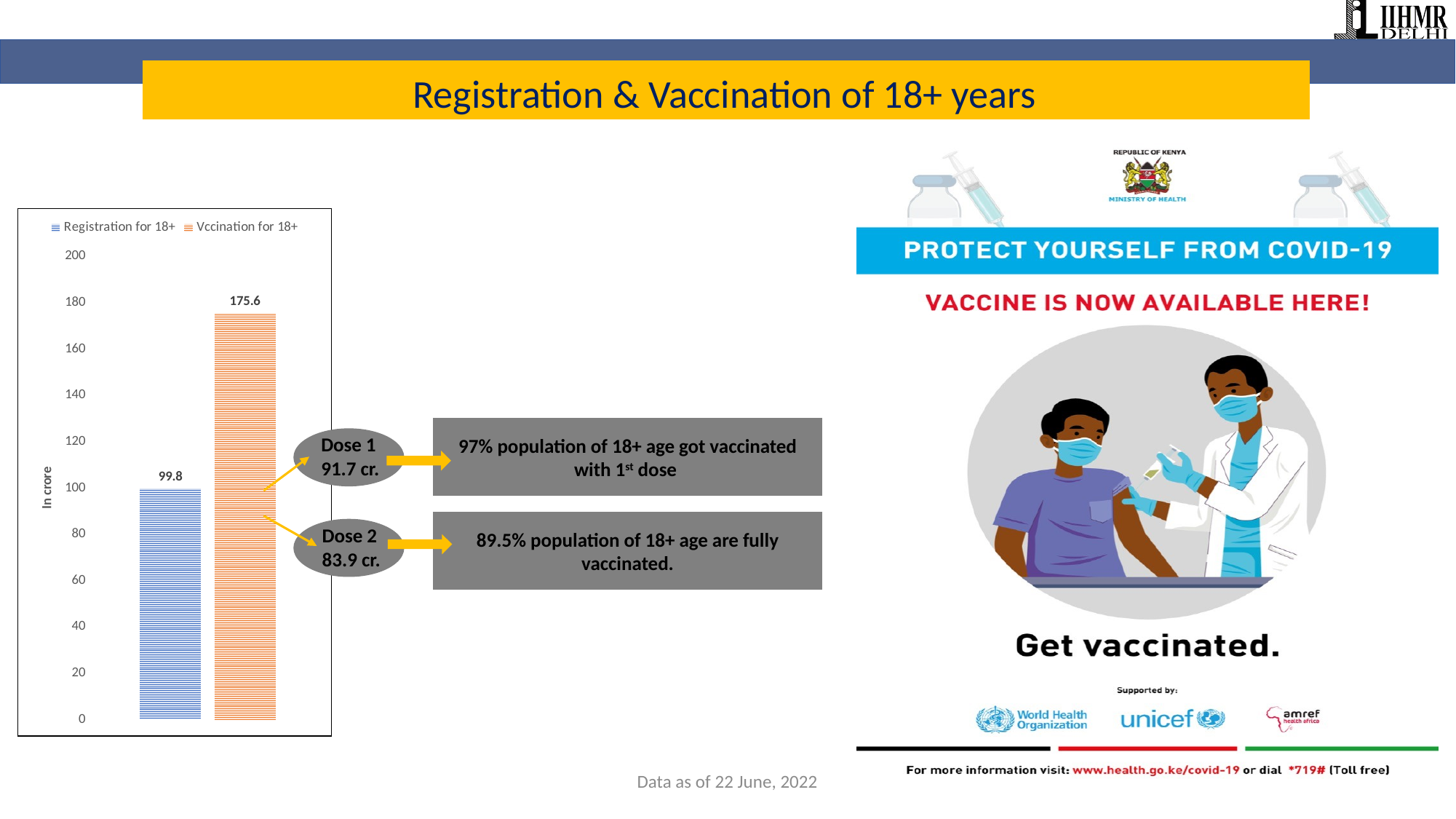
What is the difference between the Vccination for 18+ value and the Registration for 18+ value? 75.8 What is the value of the Registration for 18+ bar? 99.8 Which bar is the lowest in the chart? Registration for 18+ How many series does the chart legend list? 2 Which bar is higher, Registration for 18+ or Vccination for 18+? Vccination for 18+ Is the Registration for 18+ value greater or less than 100? less What type of chart is shown on the slide? bar chart How many bars are plotted in the chart? 2 What is the value of the Vccination for 18+ bar? 175.6 Is the Vccination for 18+ value greater or less than 160? greater What is the label on the vertical axis of the chart? In crore What is the maximum value shown on the chart's vertical axis? 200